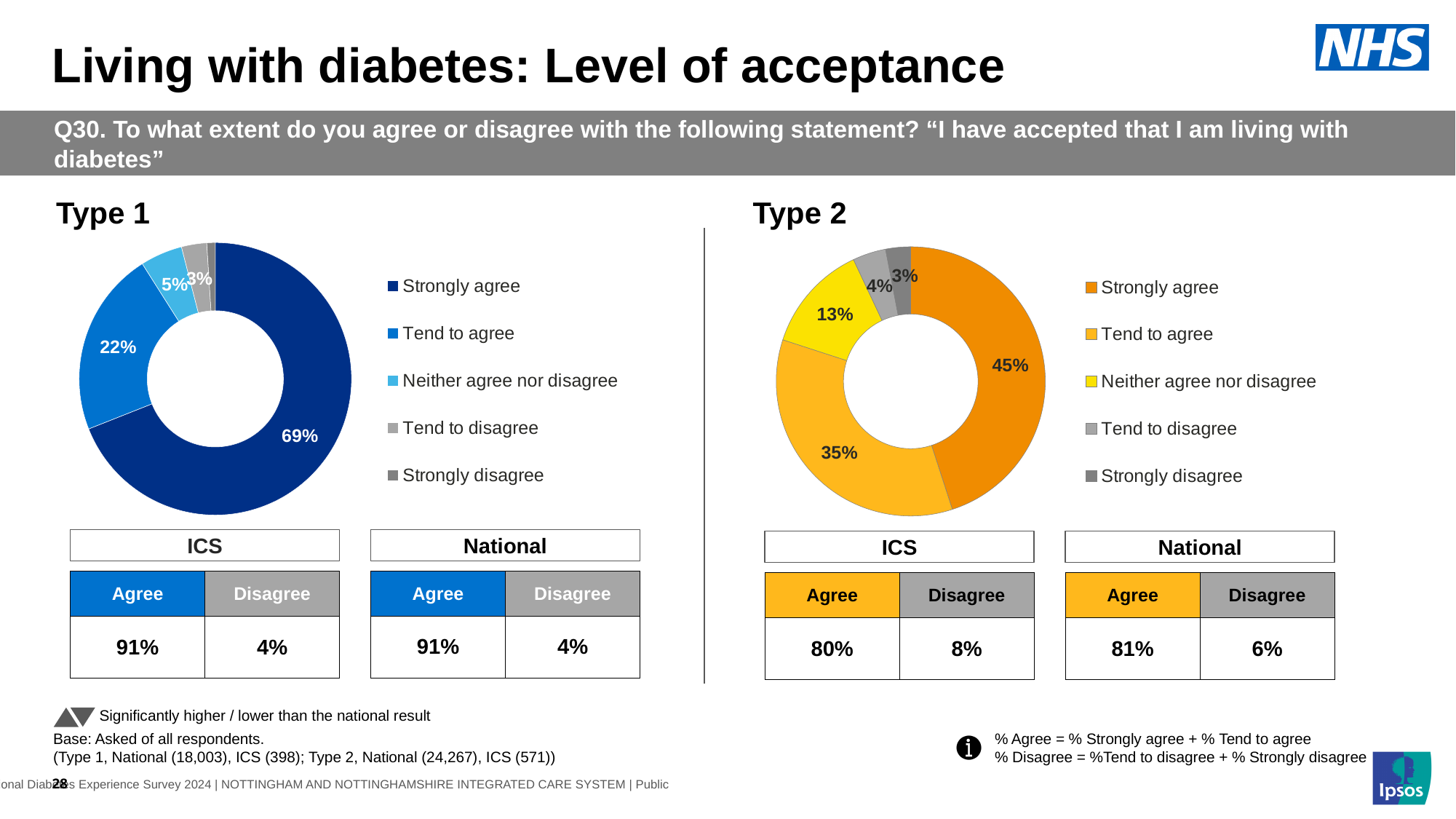
In the Type 2 chart, which category has the largest share? Strongly agree In the Type 1 chart, which category has the largest share? Strongly agree In the Type 1 chart, what is the difference between the Strongly agree and Tend to agree shares? 47% In the Type 2 chart, what percentage of respondents neither agree nor disagree? 13% In the Type 2 chart, what percentage of respondents strongly agree? 45% How many categories does the legend of the Type 2 chart list? 5 What kind of chart is used for Type 1 and Type 2? Donut (pie) chart In the Type 2 chart, what is the difference between the Strongly agree and Tend to agree shares? 10% In the Type 2 chart, what percentage of respondents tend to disagree? 4% In the Type 1 chart, what percentage of respondents tend to agree? 22% In the Type 1 chart, what percentage of respondents strongly agree? 69% Which is larger: the Tend to agree share in the Type 1 chart or the Tend to agree share in the Type 2 chart? Type 2